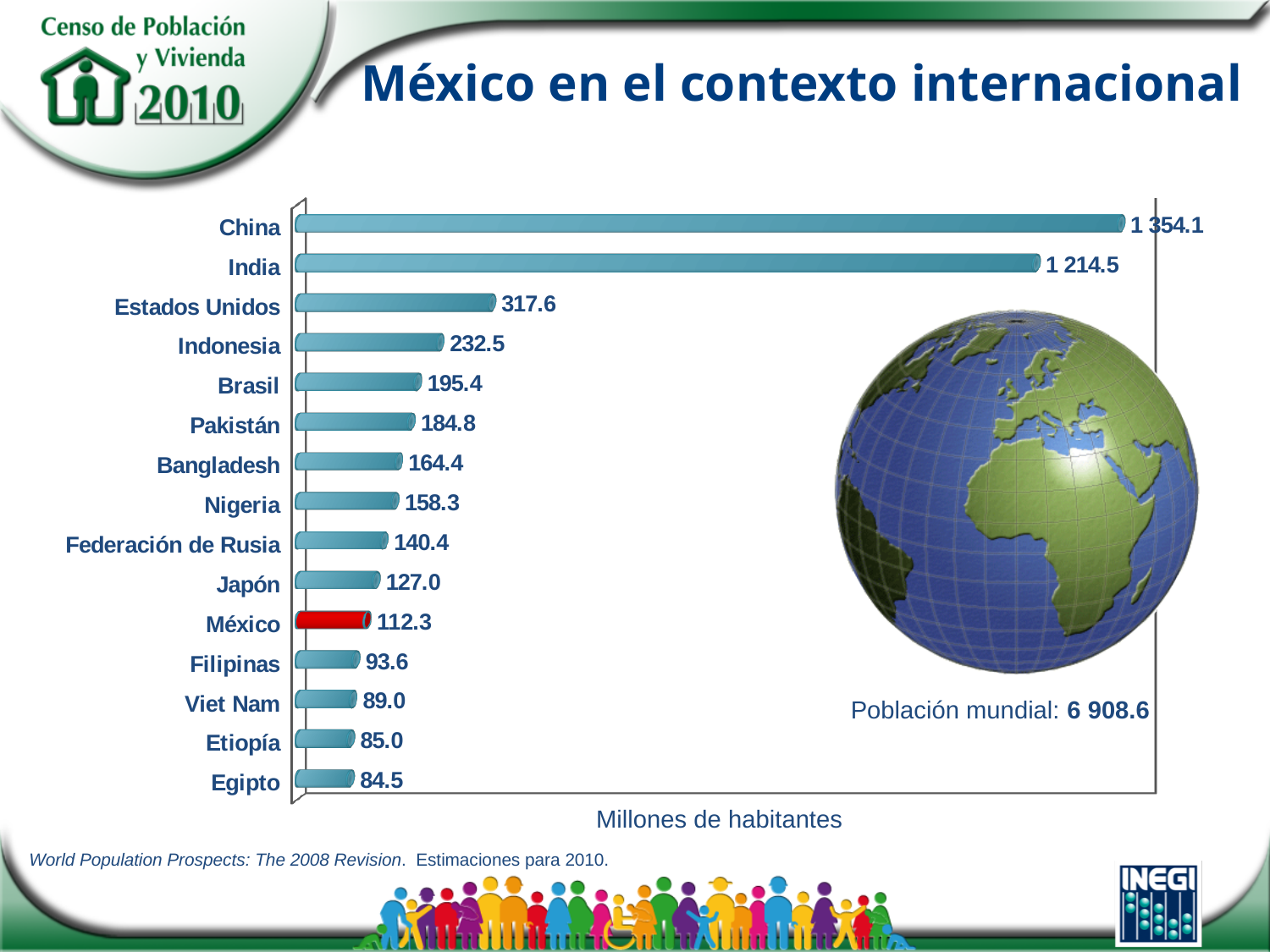
How many countries are shown in the chart? 15 What is the value shown for México? 112.3 What is the value shown for Bangladesh? 164.4 Which country has the highest value? China What unit is given for the values in the chart? Millones de habitantes What is the difference between the values for Japón and México? 14.7 Which country's bar is coloured red? México What kind of chart is shown on the slide? Bar chart Which is larger, the value for Brasil or the value for Pakistán? Brasil Which country has the lowest value? Egipto What is the difference between the values for China and India? 139.6 What is the value shown for Estados Unidos? 317.6